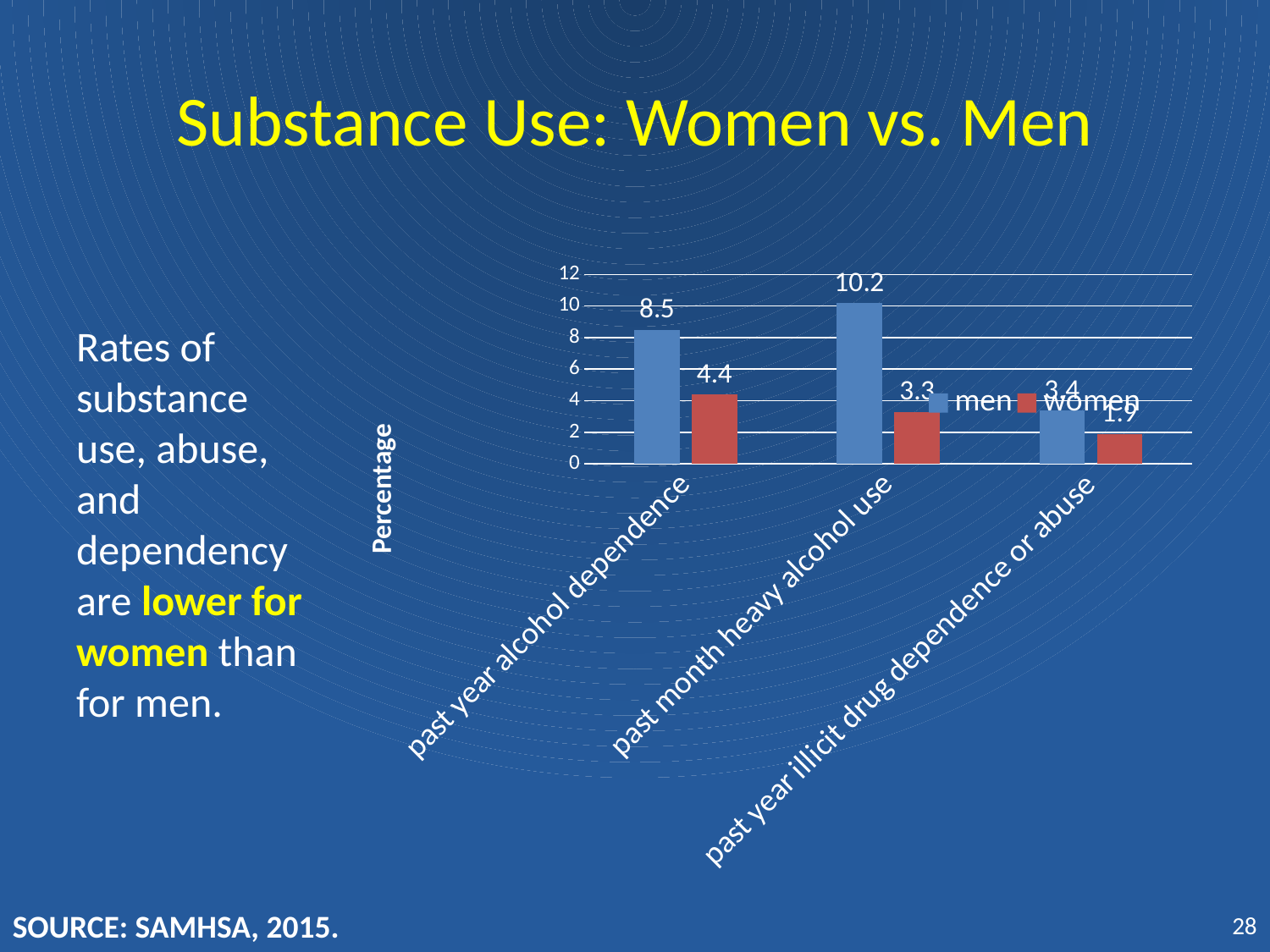
Which is larger for past year alcohol dependence, the value for men or the value for women? men How many categories are shown on the x axis? 3 Which category has the lowest value for women? past year illicit drug dependence or abuse What is the value for men for past month heavy alcohol use? 10.2 Which category has the highest value for men? past month heavy alcohol use Is the value for men for past month heavy alcohol use greater or less than 8? greater What kind of chart is shown on the slide? bar chart What is the value for women for past year alcohol dependence? 4.4 What is the value for women for past month heavy alcohol use? 3.3 What is the value for men for past year alcohol dependence? 8.5 How many series does the legend list? 2 What is the difference between the men and women values for past month heavy alcohol use? 6.9